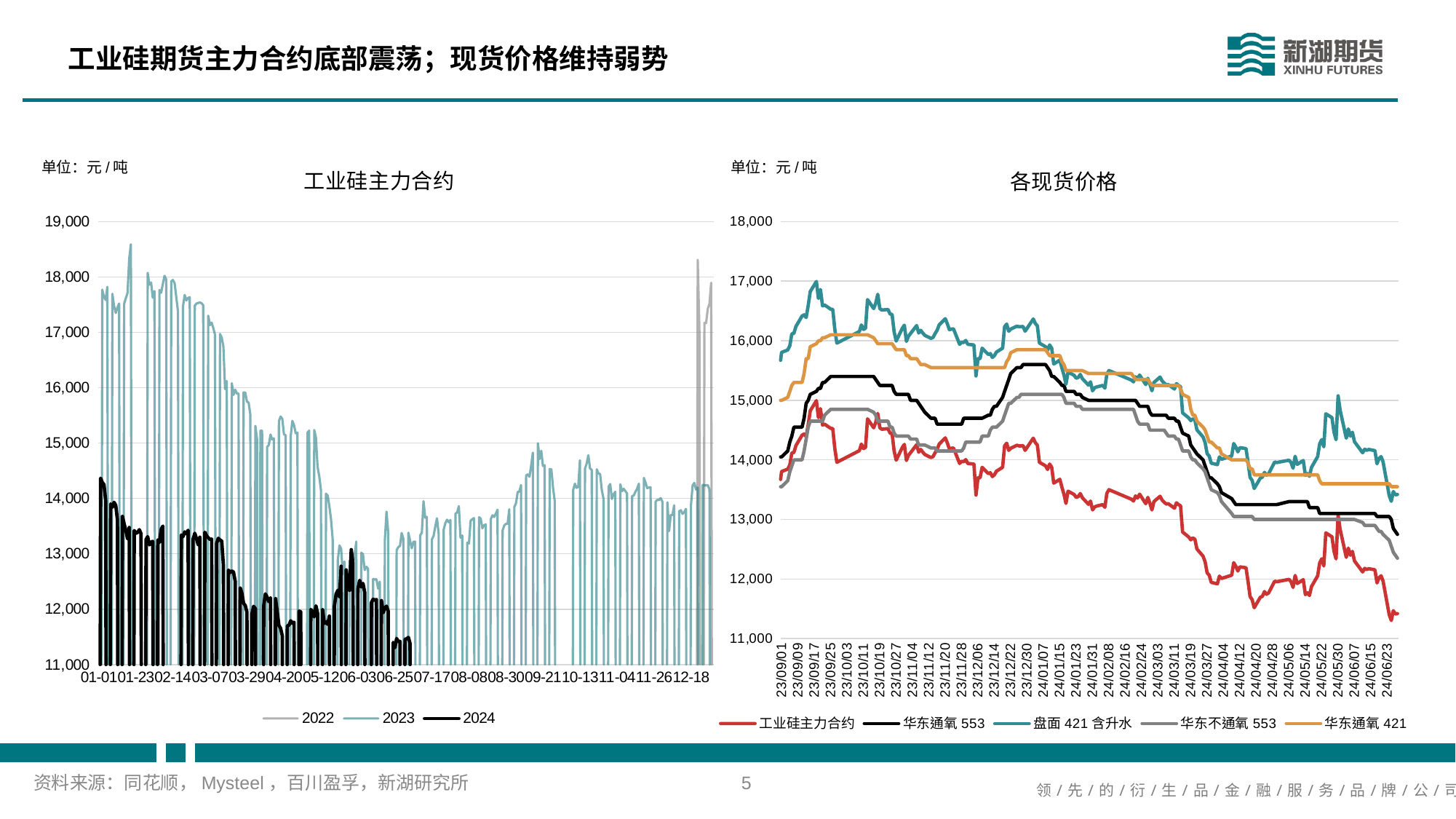
In the right chart 各现货价格, is the final value of the 华东通氧 421 series greater or less than 13,000? greater How many series does the legend of the right chart 各现货价格 list? 5 In the left chart 工业硅主力合约, does the 2024 series rise or fall overall from left to right? fall In the right chart 各现货价格, does the 华东不通氧 553 series rise or fall overall from 23/09/01 to 24/06/23? fall What unit is shown for the values in the right chart 各现货价格? 元 / 吨 What is the title of the right chart on the slide? 各现货价格 In the right chart 各现货价格, is the final value of the 工业硅主力合约 series greater or less than 12,000? less In the left chart 工业硅主力合约, is the value of the 2024 series at the start of the year greater or less than 15,000? less How many series does the legend of the left chart 工业硅主力合约 list? 3 What kind of chart is the left chart titled 工业硅主力合约? line chart In the left chart 工业硅主力合约, does the 2023 series rise or fall overall from left to right? fall